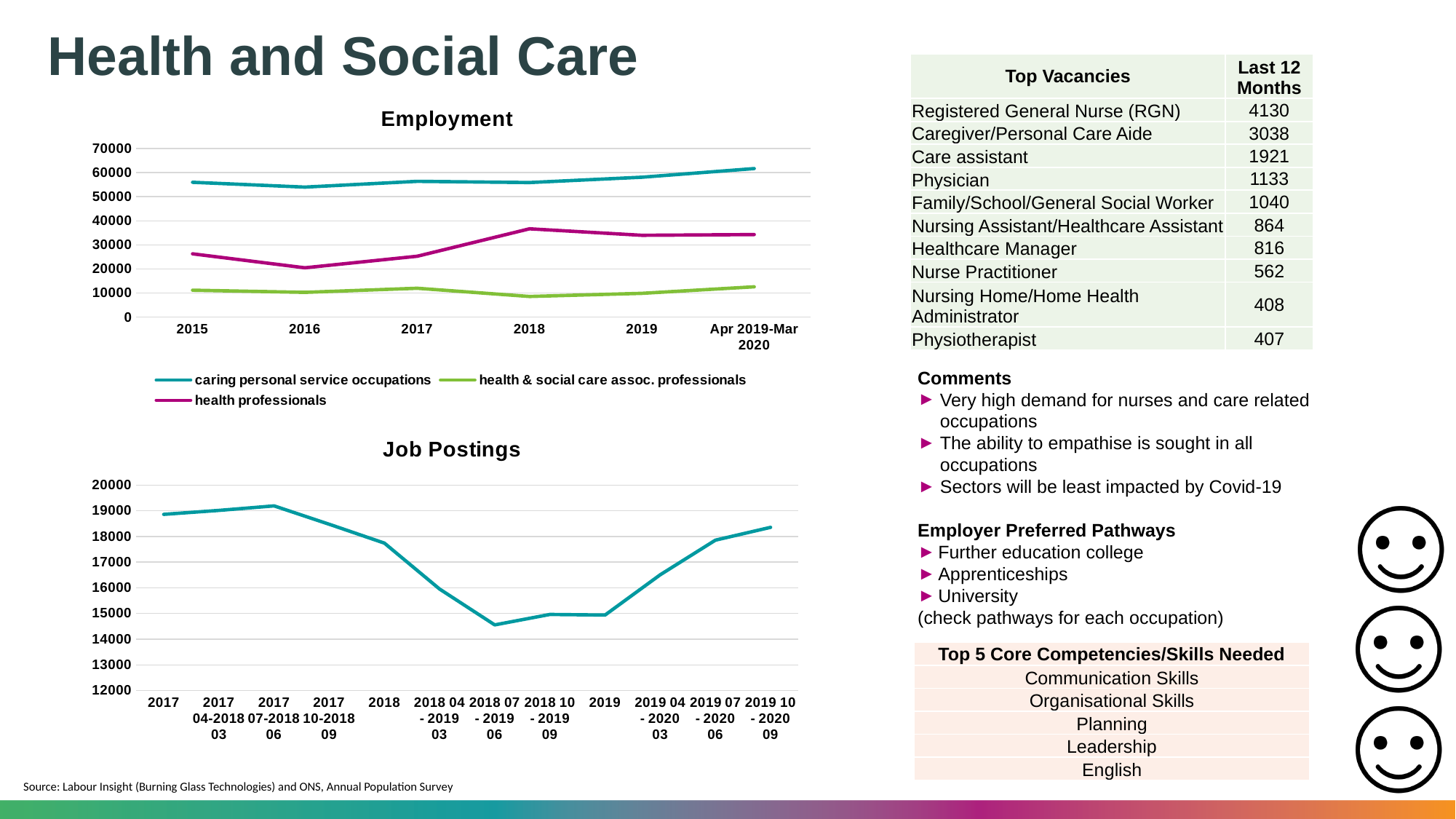
How many time periods are shown on the x axis of the Employment chart? 6 In the Job Postings chart, which period has the lowest value? 2018 07 - 2019 06 In the Employment chart, which series has the highest values across all periods? caring personal service occupations In the Job Postings chart, which period has the highest value? 2017 07-2018 06 What kind of chart is the Employment chart? line chart How many data points are plotted in the Job Postings chart? 12 In the Employment chart, is the value for health professionals larger in 2016 or in 2018? 2018 In the Employment chart, is the value for health professionals in 2016 greater or less than 30000? less In the Employment chart, do the values for health professionals rise or fall from 2016 to 2018? rise In the Employment chart, is the value for caring personal service occupations in 2015 greater or less than 50000? greater How many series does the legend of the Employment chart list? 3 In the Job Postings chart, is the value for 2018 07 - 2019 06 greater or less than 15000? less